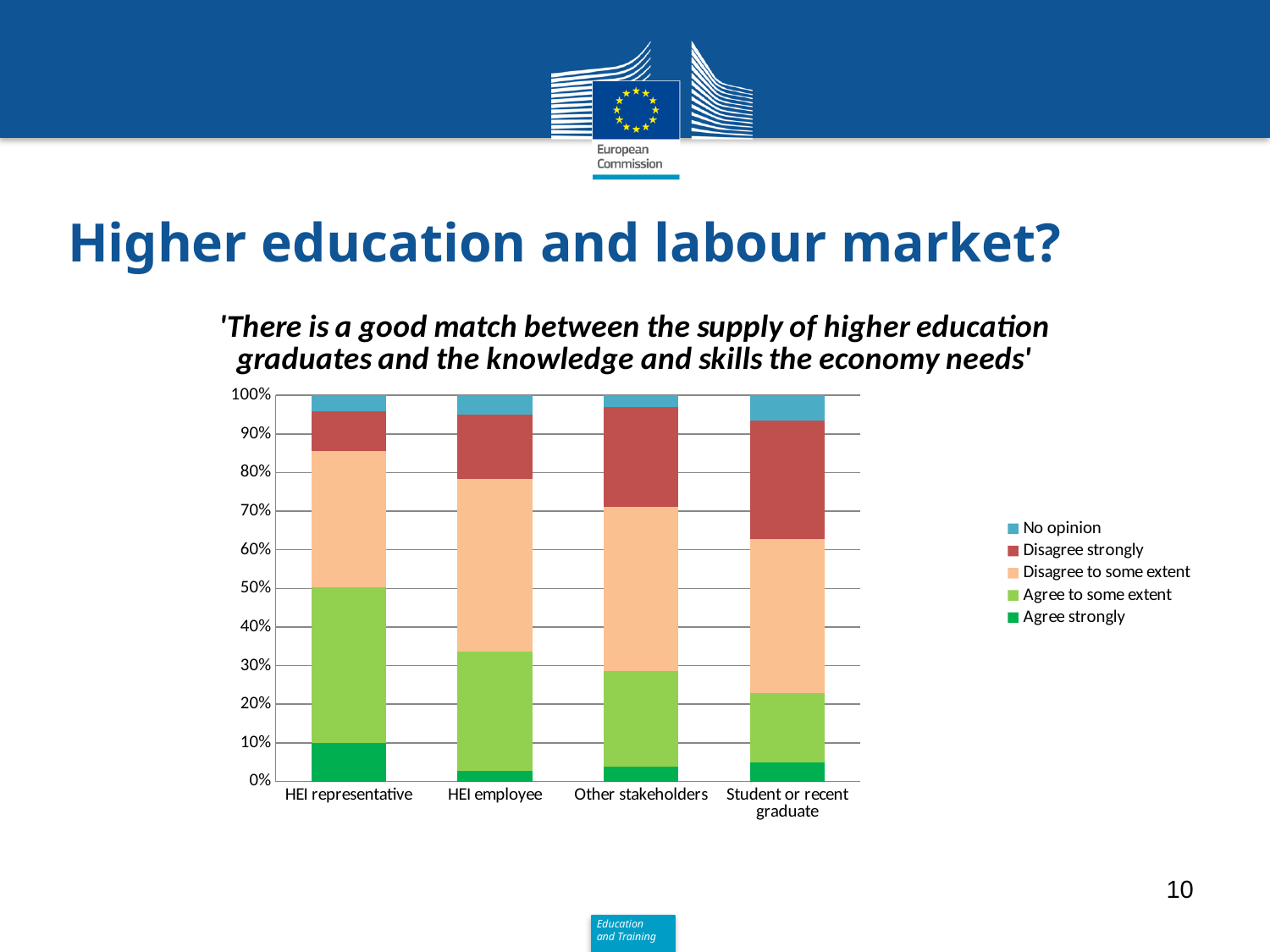
How many respondent categories are shown along the x axis? 4 Moving from HEI representative to Student or recent graduate, does the 'Agree to some extent' share rise or fall? fall Is the 'Disagree strongly' share for HEI representative greater or less than 20%? less Is the 'Agree to some extent' share for HEI representative greater or less than 30%? greater How many series does the legend list? 5 Which legend entry is listed first (at the top) in the legend? No opinion Is the 'Disagree strongly' share for Student or recent graduate greater or less than 20%? greater What kind of chart is shown on the slide? Stacked bar chart Which has the larger 'Disagree strongly' segment, Other stakeholders or HEI employee? Other stakeholders Which respondent category has the largest 'Disagree strongly' segment? Student or recent graduate Which respondent category has the largest 'Agree strongly' segment? HEI representative Which respondent category has the smallest 'Agree to some extent' segment? Student or recent graduate